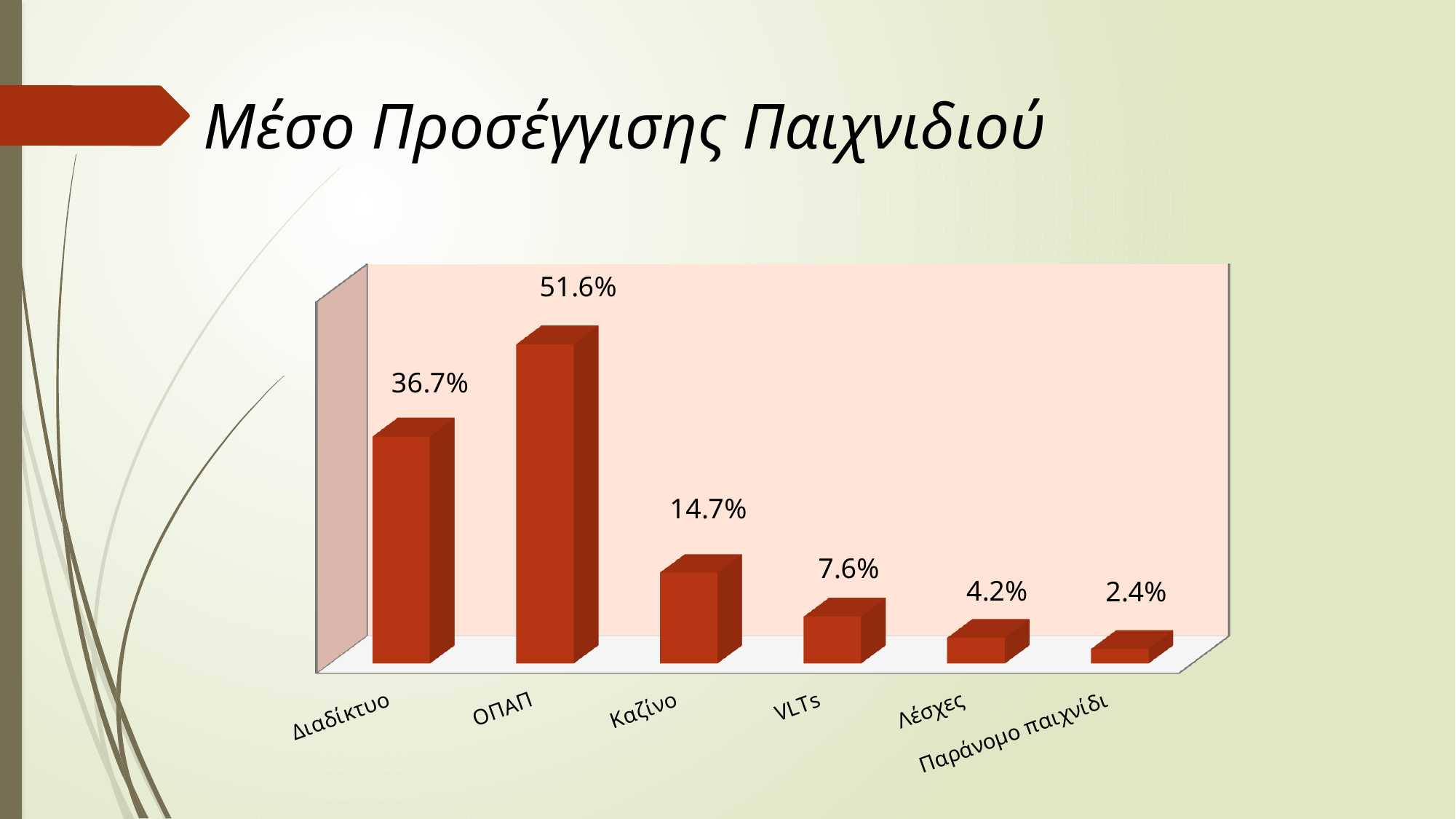
Which is larger, the value for Λέσχες or the value for VLTs? VLTs What is the difference between the values for ΟΠΑΠ and Διαδίκτυο? 14.9% Which category has the lowest value? Παράνομο παιχνίδι What is the title of the slide? Μέσο Προσέγγισης Παιχνιδιού What is the value for Καζίνο? 14.7% What kind of chart is shown on the slide? Bar chart What is the value for ΟΠΑΠ? 51.6% What is the value for Διαδίκτυο? 36.7% What is the value for VLTs? 7.6% Which category has the highest value? ΟΠΑΠ What is the value for Παράνομο παιχνίδι? 2.4% How many categories are shown in the chart? 6